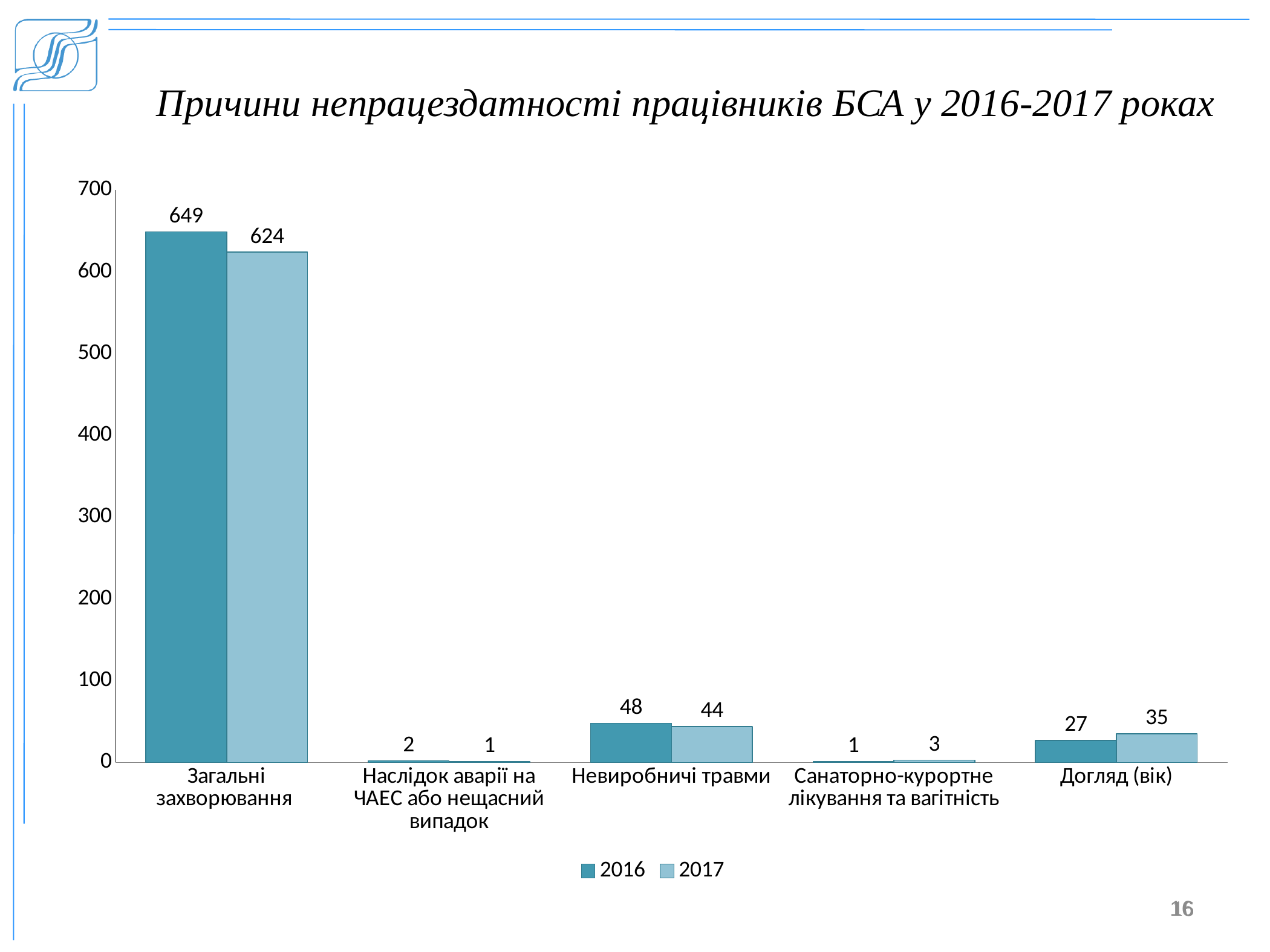
Is the 2017 value for Загальні захворювання greater or less than 600? greater What is the difference between the 2016 and 2017 values for Загальні захворювання? 25 What is the value for Загальні захворювання in 2016? 649 How many categories are shown on the x axis? 5 Which is larger for Догляд (вік): the 2016 value or the 2017 value? 2017 What is the value for Догляд (вік) in 2017? 35 What is the title of the chart? Причини непрацездатності працівників БСА у 2016-2017 роках What is the value for Невиробничі травми in 2017? 44 What kind of chart is shown on the slide? bar chart Which category has the highest value in 2016? Загальні захворювання Which category has the lowest value in 2017? Наслідок аварії на ЧАЕС або нещасний випадок How many series does the legend list? 2